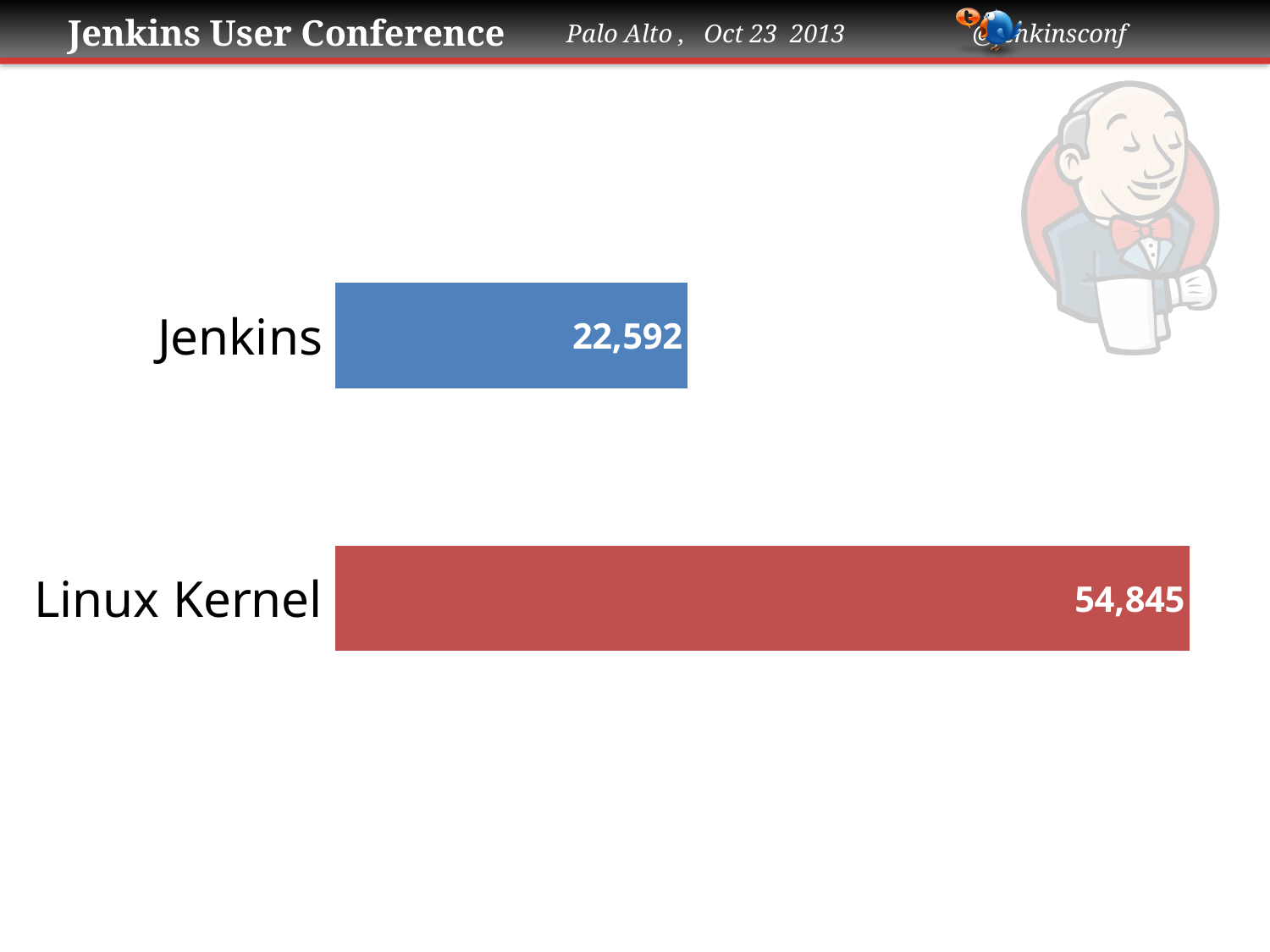
What colour is the bar for Linux Kernel? red What is the value for Linux Kernel? 54,845 What colour is the bar for Jenkins? blue Which is larger, the value for Jenkins or the value for Linux Kernel? Linux Kernel Which category has the lowest value? Jenkins What kind of chart is shown on the slide? bar chart Which category has the highest value? Linux Kernel How many categories are shown in the chart? 2 What is the difference between the Linux Kernel value and the Jenkins value? 32,253 What is the value for Jenkins? 22,592